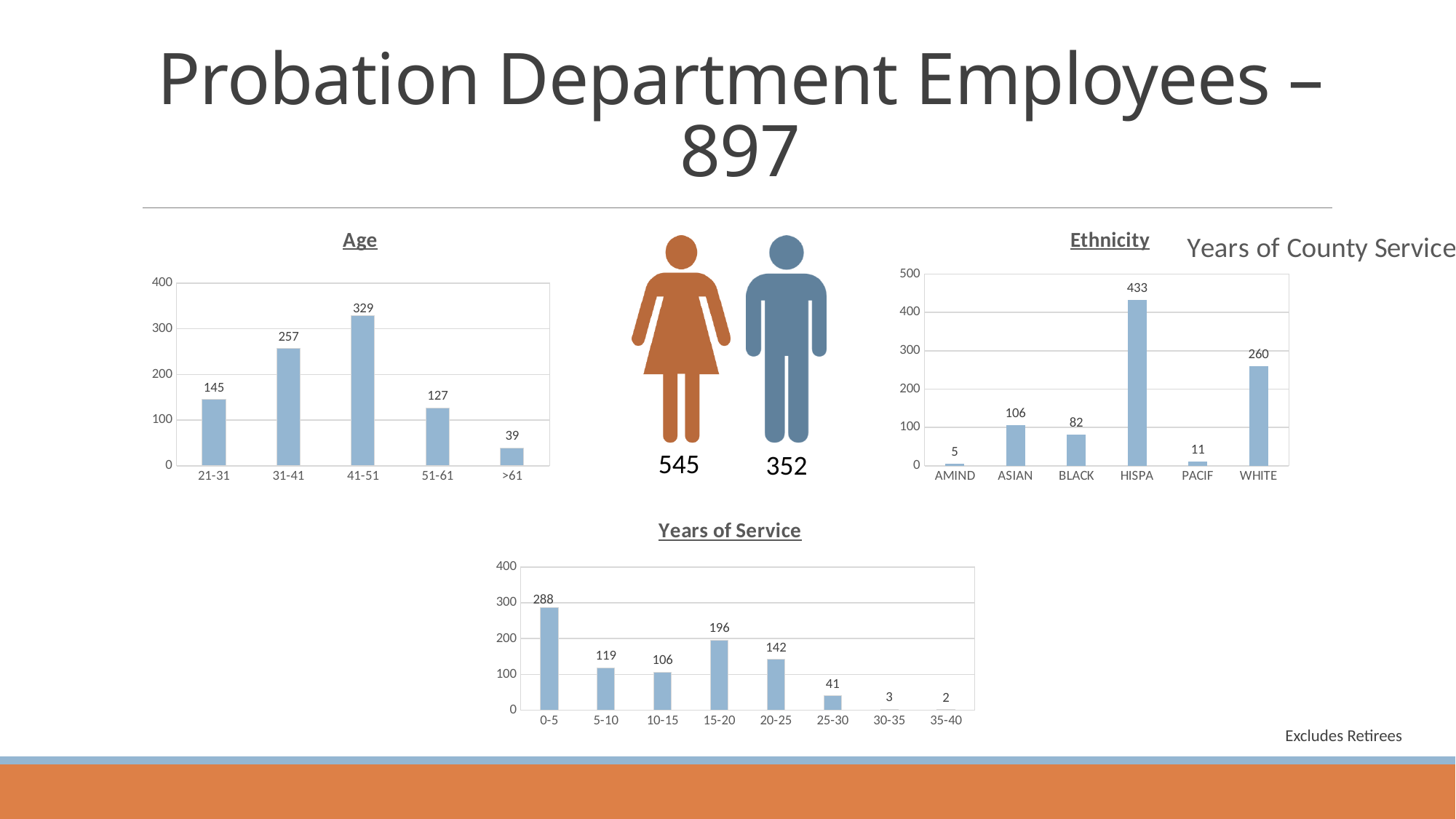
In the Age chart, what is the difference between the 31-41 and 51-61 values? 130 How many categories are shown in the Ethnicity chart? 6 What type of chart is the Age chart? Bar chart In the Years of Service chart, what is the difference between the 0-5 and 5-10 values? 169 In the Years of Service chart, which category has the highest value? 0-5 In the Ethnicity chart, which is larger, ASIAN or BLACK? ASIAN In the Ethnicity chart, which category has the highest value? HISPA In the Ethnicity chart, what is the value for HISPA? 433 In the Age chart, which age category has the lowest value? >61 In the Years of Service chart, what is the value for 15-20? 196 In the Age chart, what is the value for the 41-51 category? 329 How many categories are shown in the Years of Service chart? 8